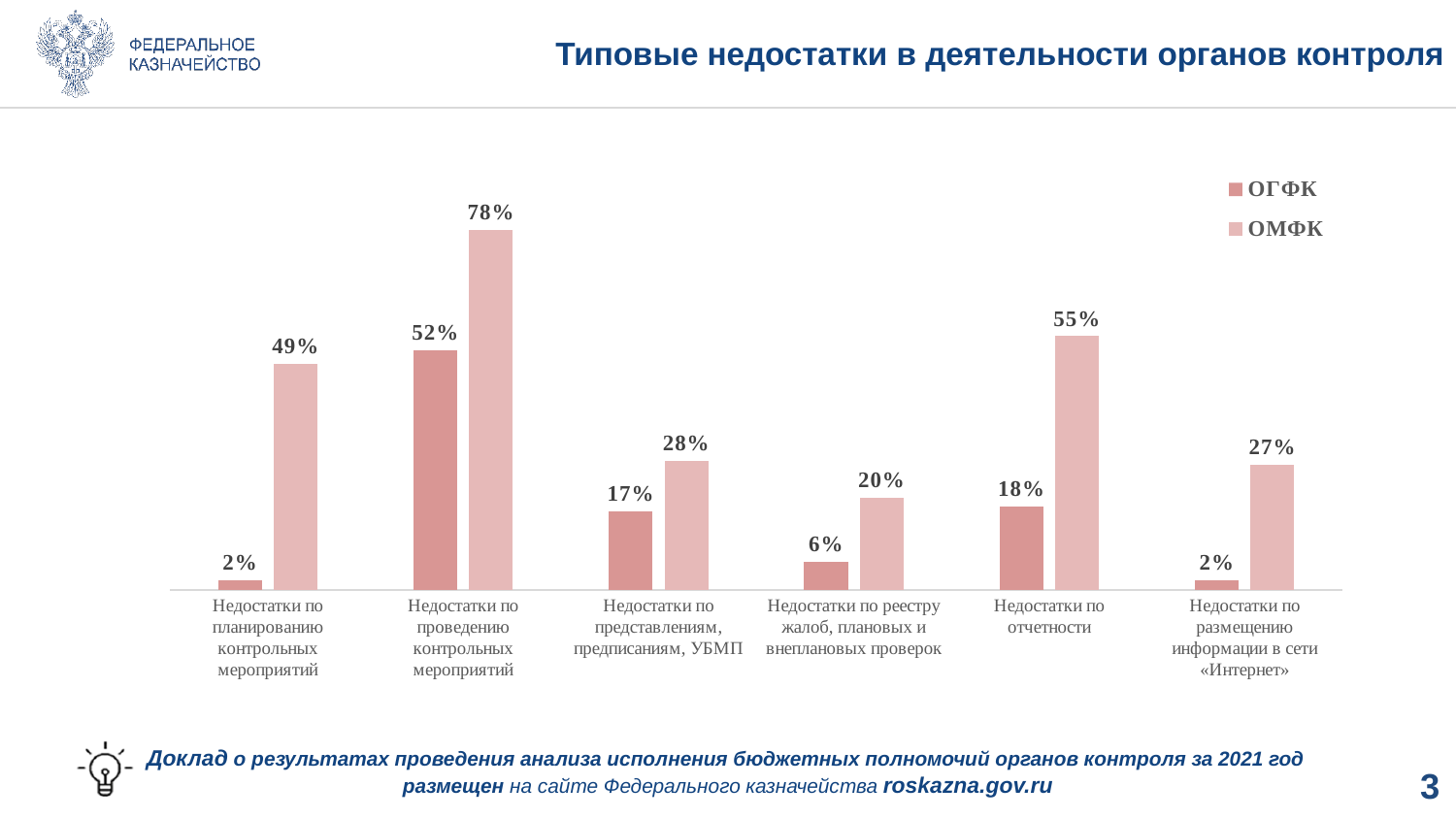
Which is larger: the ОГФК value for «Недостатки по представлениям, предписаниям, УБМП» or the ОГФК value for «Недостатки по реестру жалоб, плановых и внеплановых проверок»? Недостатки по представлениям, предписаниям, УБМП Which category has the lowest ОМФК value? Недостатки по реестру жалоб, плановых и внеплановых проверок What is the difference between the ОМФК and ОГФК values for «Недостатки по отчетности»? 37% What kind of chart is shown on the slide? Bar chart What is the ОМФК value for «Недостатки по проведению контрольных мероприятий»? 78% What is the ОГФК value for «Недостатки по отчетности»? 18% What is the ОМФК value for «Недостатки по размещению информации в сети «Интернет»»? 27% What is the difference between the ОМФК and ОГФК values for «Недостатки по планированию контрольных мероприятий»? 47% Which series is shown in the darker pink colour in the legend? ОГФК Which category has the highest ОМФК value? Недостатки по проведению контрольных мероприятий How many series does the legend list? 2 How many categories are shown on the x axis of the chart? 6